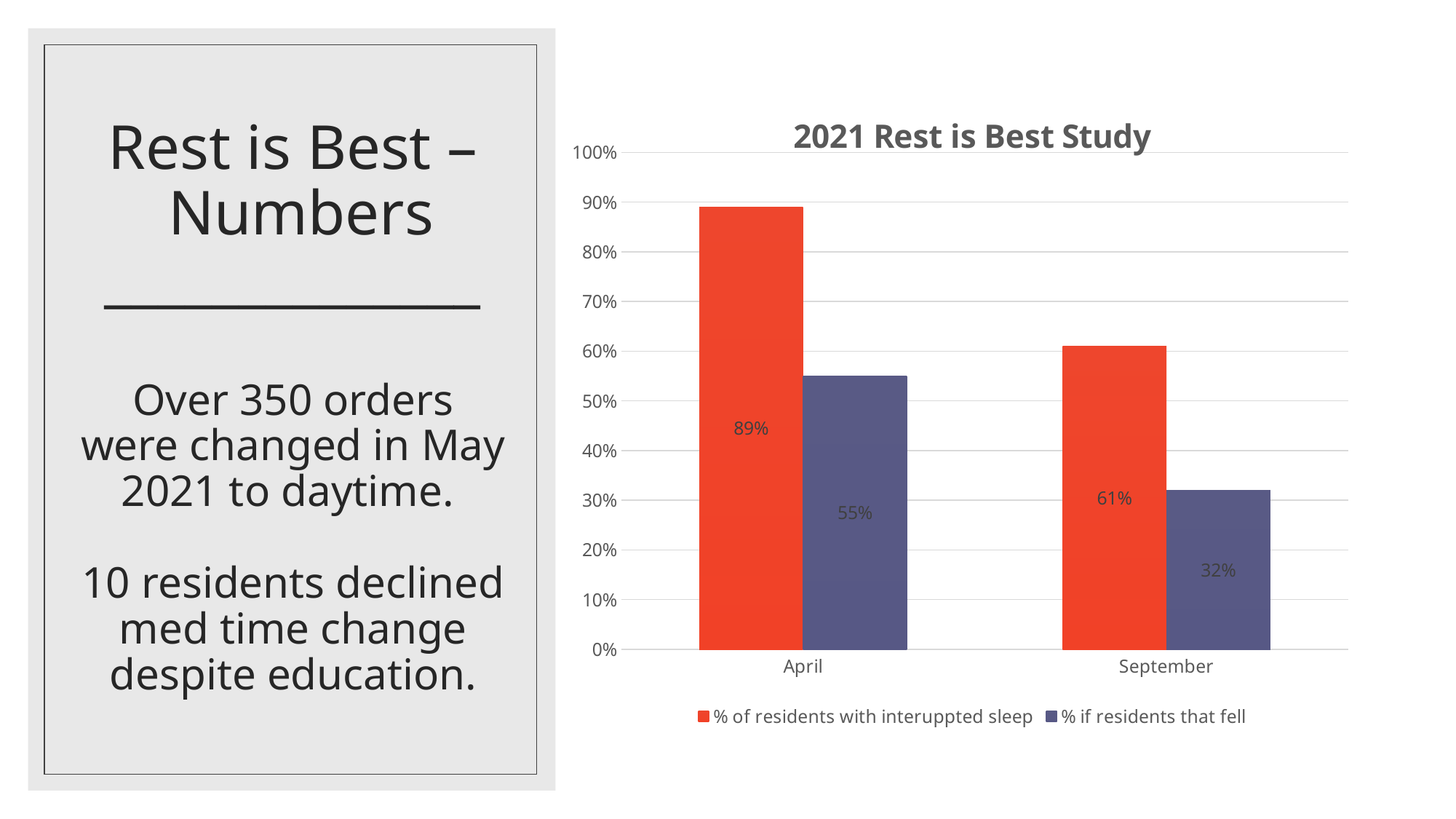
Is the percentage of residents that fell higher in April or in September? April What is the percentage of residents with interrupted sleep in September? 61% What is the percentage of residents that fell in September? 32% What is the percentage of residents with interrupted sleep in April? 89% What is the percentage of residents that fell in April? 55% Which month has the lowest percentage of residents that fell? September How many months are shown on the x axis? 2 What is the title of the chart? 2021 Rest is Best Study How many series does the legend list? 2 Which month has the highest percentage of residents with interrupted sleep? April By how many percentage points did the share of residents with interrupted sleep fall from April to September? 28 What kind of chart is shown on the slide? Bar chart